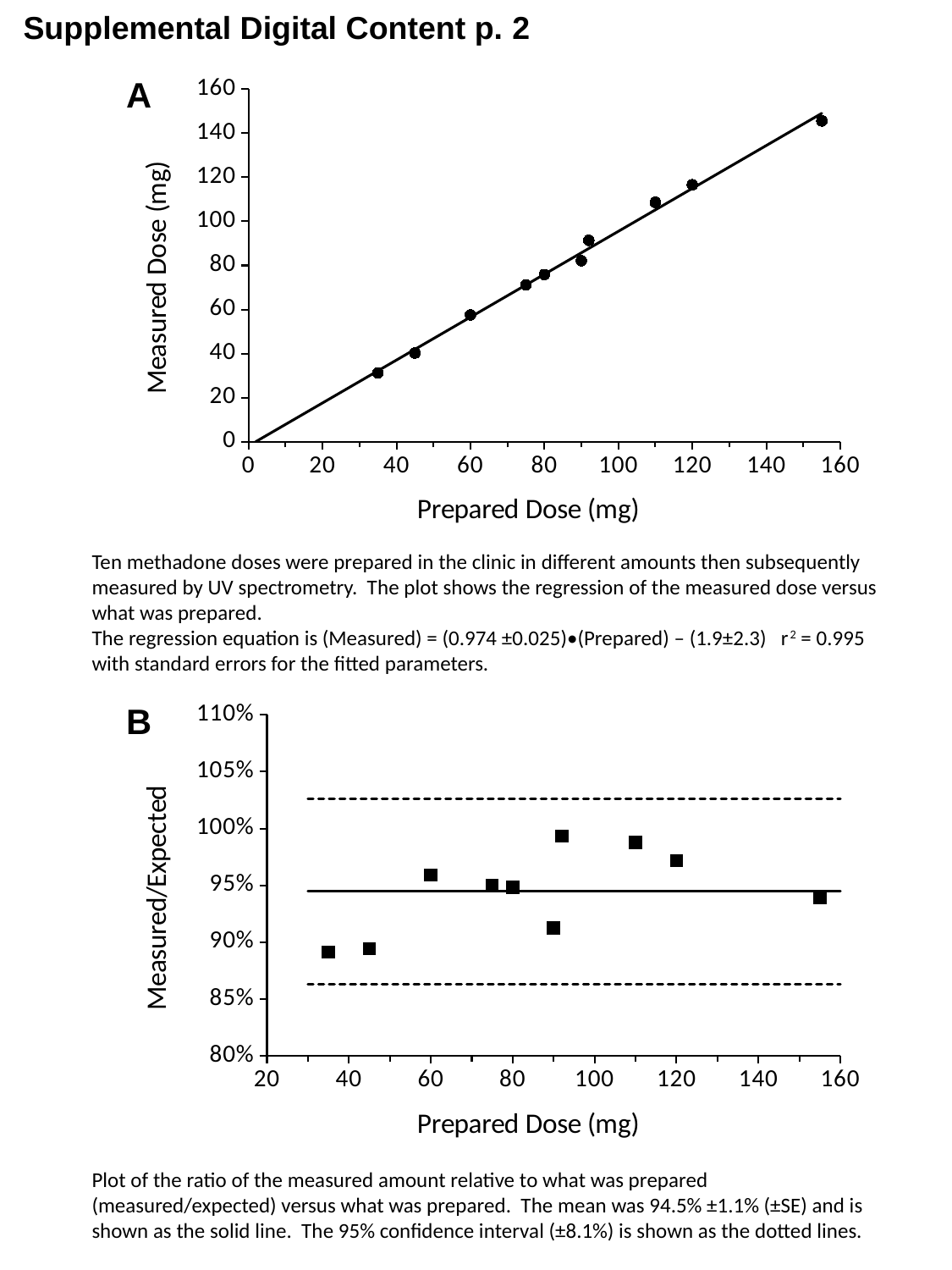
What kind of chart is chart B (the bottom chart)? scatter plot What kind of chart is chart A (the top chart)? scatter plot In chart B, is the measured/expected ratio for the point at a prepared dose of about 35 mg greater or less than 90%? less In chart A, how many data points are plotted? 10 In chart A, is the measured dose for the point at a prepared dose of 120 mg greater or less than 120? less In chart B, is the measured/expected ratio for the point at a prepared dose of 60 mg greater or less than 95%? greater In chart A, do the measured dose values rise or fall as the prepared dose increases? rise In chart B, how many data points are plotted? 10 What is the x-axis label of chart B? Prepared Dose (mg) What is the y-axis label of chart A? Measured Dose (mg)